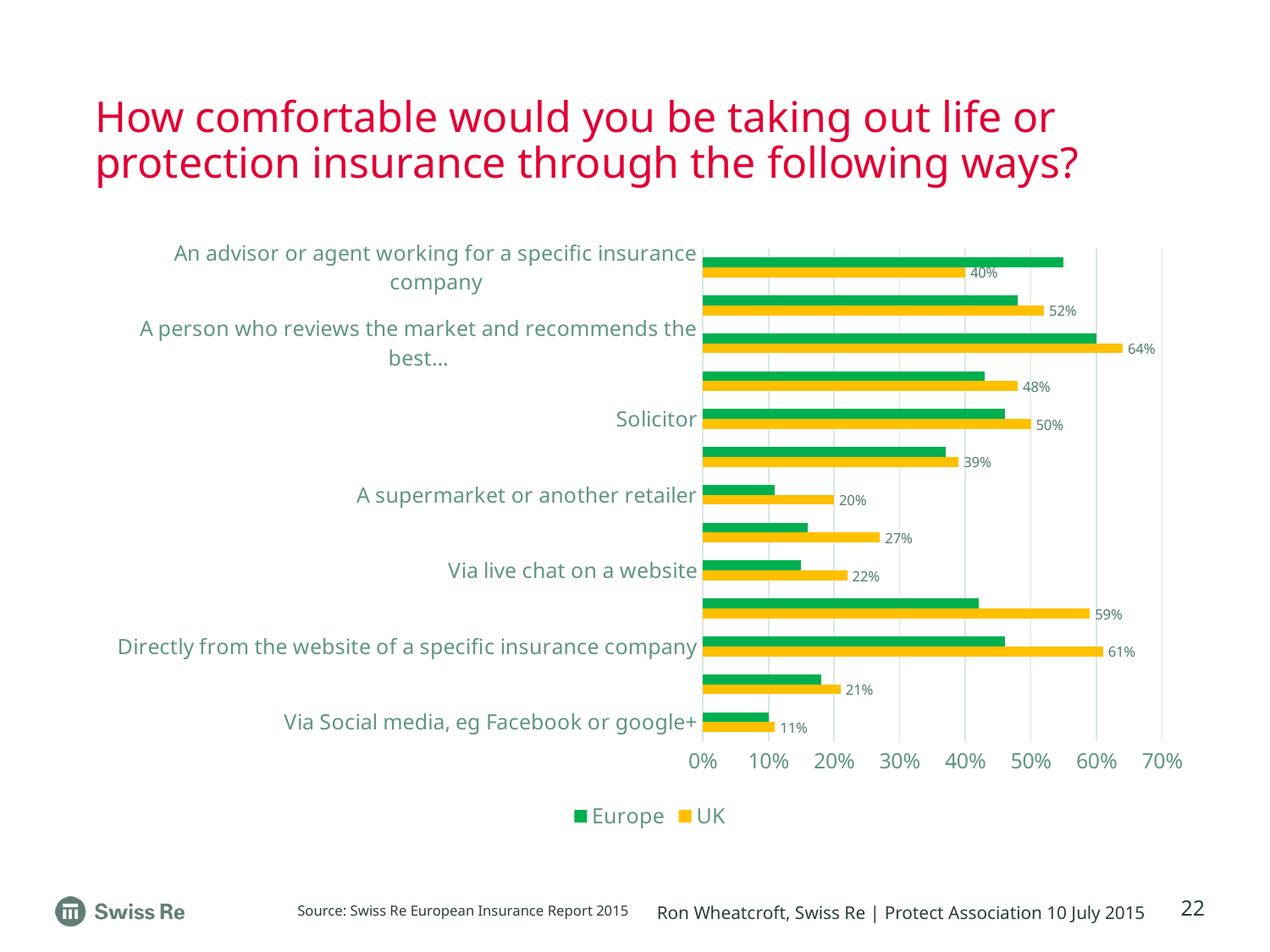
Is the Europe value for 'A supermarket or another retailer' greater or less than 20%? less What is the UK value for 'Directly from the website of a specific insurance company'? 61% What is the UK value for 'An advisor or agent working for a specific insurance company'? 40% For 'An advisor or agent working for a specific insurance company', which is larger, the Europe value or the UK value? Europe What kind of chart is shown on the slide? Bar chart How many series does the legend list? 2 What is the difference between the UK values for 'Directly from the website of a specific insurance company' and 'Via live chat on a website'? 39% What is the UK value for 'Solicitor'? 50% Which category has the lowest UK value? Via Social media, eg Facebook or google+ Which category has the highest UK value? A person who reviews the market and recommends the best... What is the UK value for 'Via Social media, eg Facebook or google+'? 11% What is the UK value for 'A person who reviews the market and recommends the best...'? 64%